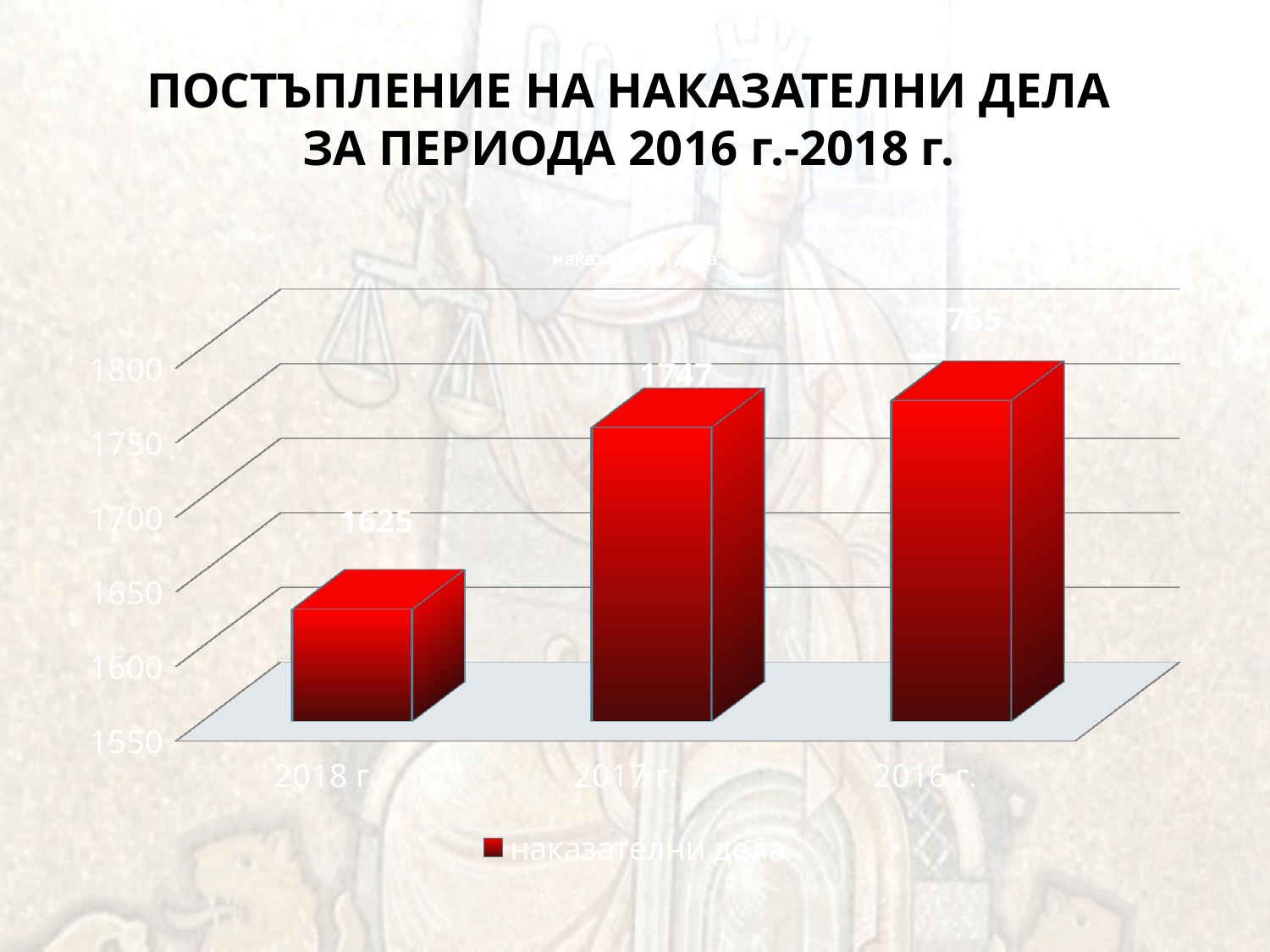
Which year has the highest value? 2016 г. What kind of chart is shown on the slide? bar chart Which is larger, the value for 2017 г. or the value for 2018 г.? 2017 г. What is the legend entry of the chart? наказателни дела Which year has the lowest value? 2018 г. What is the value for 2018 г.? 1625 What is the value for 2017 г.? 1747 Is the value for 2018 г. greater or less than 1650? less What is the difference between the values for 2017 г. and 2018 г.? 122 How many categories are shown on the x axis? 3 What is the difference between the values for 2016 г. and 2018 г.? 140 What is the value for 2016 г.? 1765